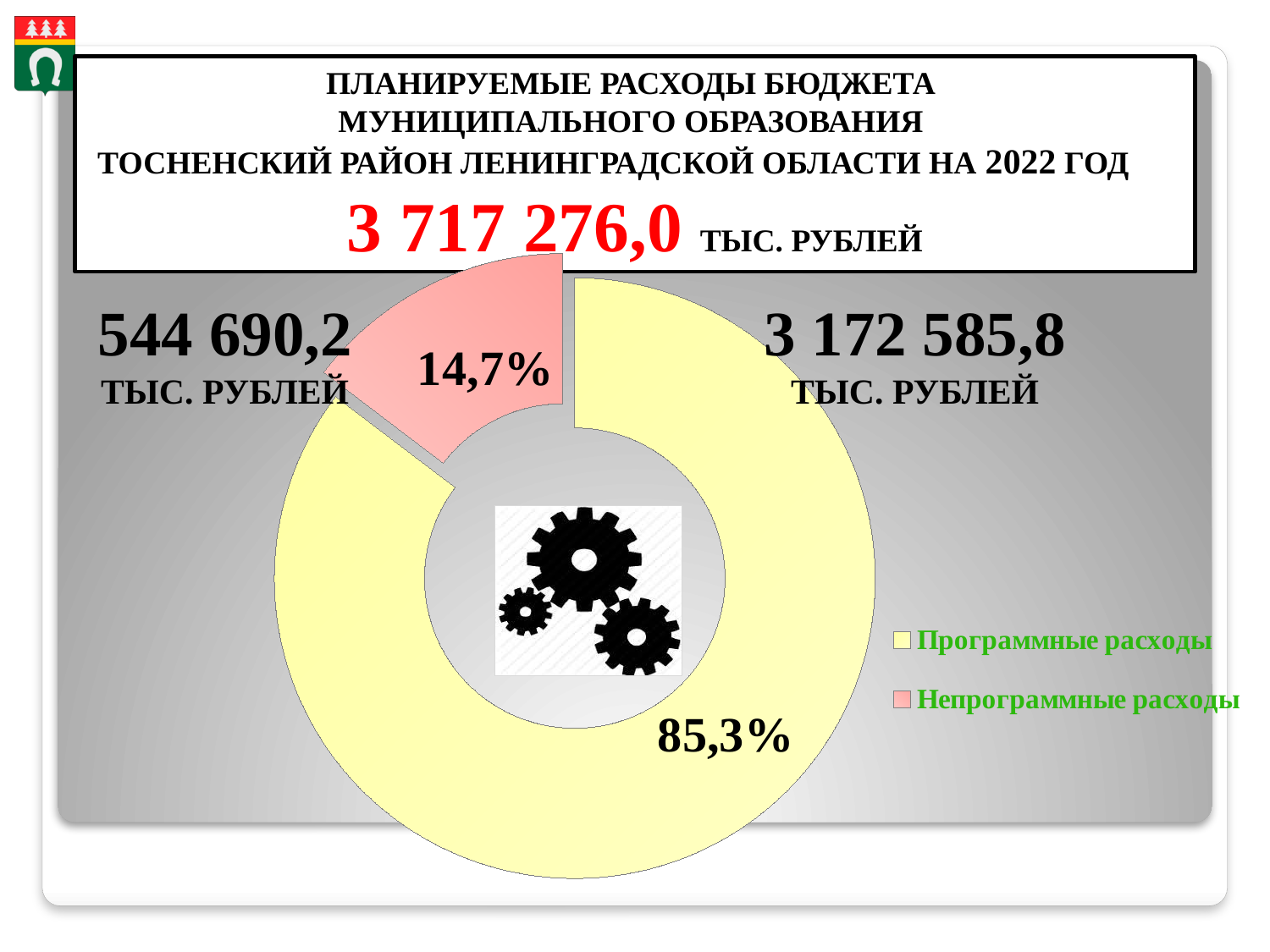
What is the difference in percentage points between the shares of Программные расходы and Непрограммные расходы? 70,6 Which category has the largest share of the chart? Программные расходы Which is larger, the share for Программные расходы or for Непрограммные расходы? Программные расходы What colour is the slice for Непрограммные расходы? Pink How many categories does the chart show? 2 What share of the chart is labelled for Программные расходы? 85,3% What share of the chart is labelled for Непрограммные расходы? 14,7% What is the value shown for Программные расходы in тыс. рублей? 3 172 585,8 How many entries does the legend list? 2 What kind of chart is shown on the slide? Pie chart (doughnut) What is the value shown for Непрограммные расходы in тыс. рублей? 544 690,2 Which category has the smallest share of the chart? Непрограммные расходы